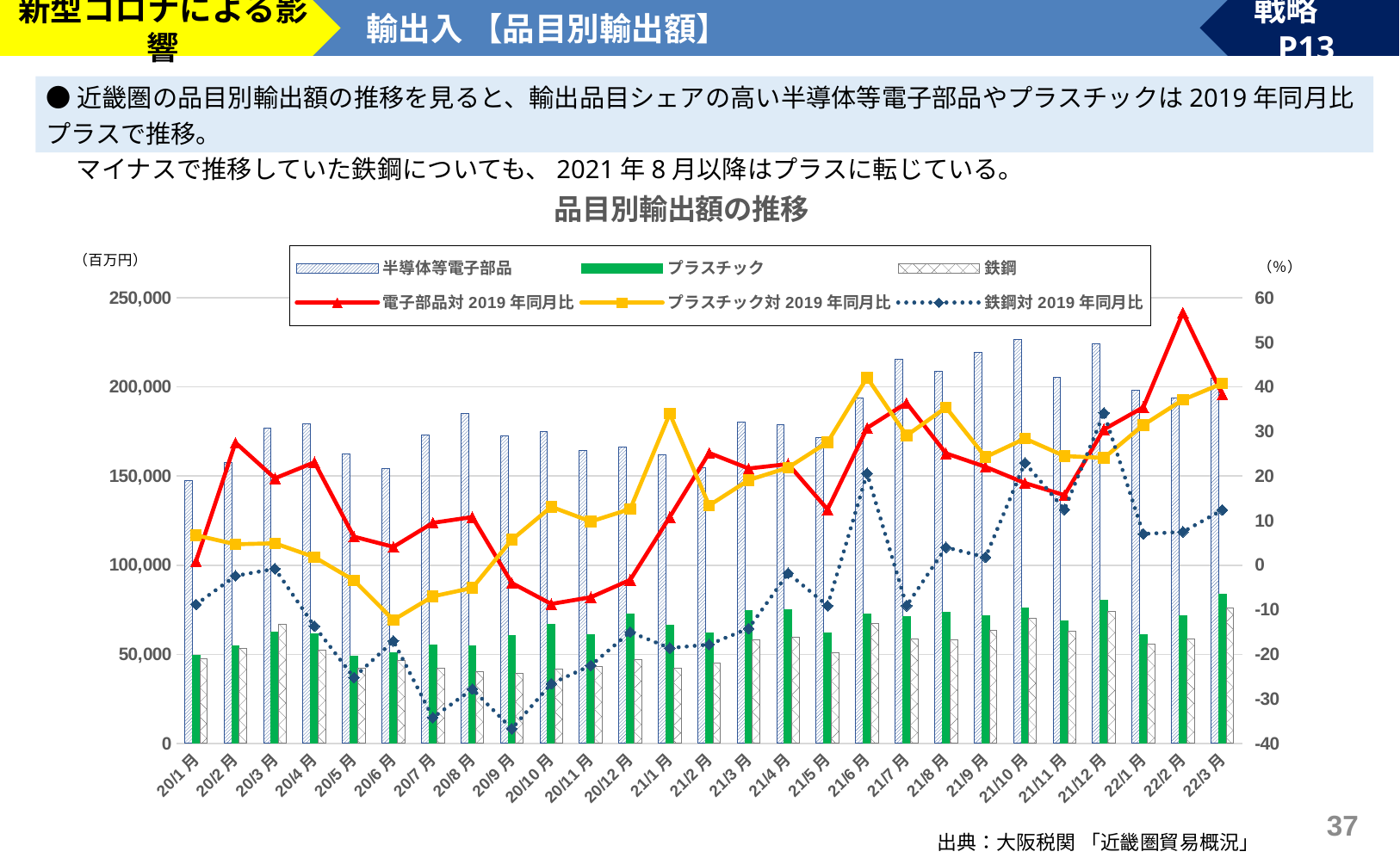
At 21/6月, which is higher: the 電子部品対2019年同月比 line or the プラスチック対2019年同月比 line? プラスチック対2019年同月比 Is the 電子部品対2019年同月比 value for 22/2月 greater or less than 50? greater Is the 鉄鋼対2019年同月比 value for 20/9月 greater or less than -30? less What unit is shown for the left vertical axis of the chart? 百万円 Is the プラスチック bar for 22/3月 greater or less than 50,000? greater How many series does the legend of the chart list? 6 In which month does the 電子部品対2019年同月比 line reach its highest value? 22/2月 What is the title of the chart? 品目別輸出額の推移 How many months are plotted along the x axis of the chart? 27 Does the 電子部品対2019年同月比 line rise or fall from 21/11月 to 22/2月? rise What kind of chart is shown on the slide? A combined bar and line chart